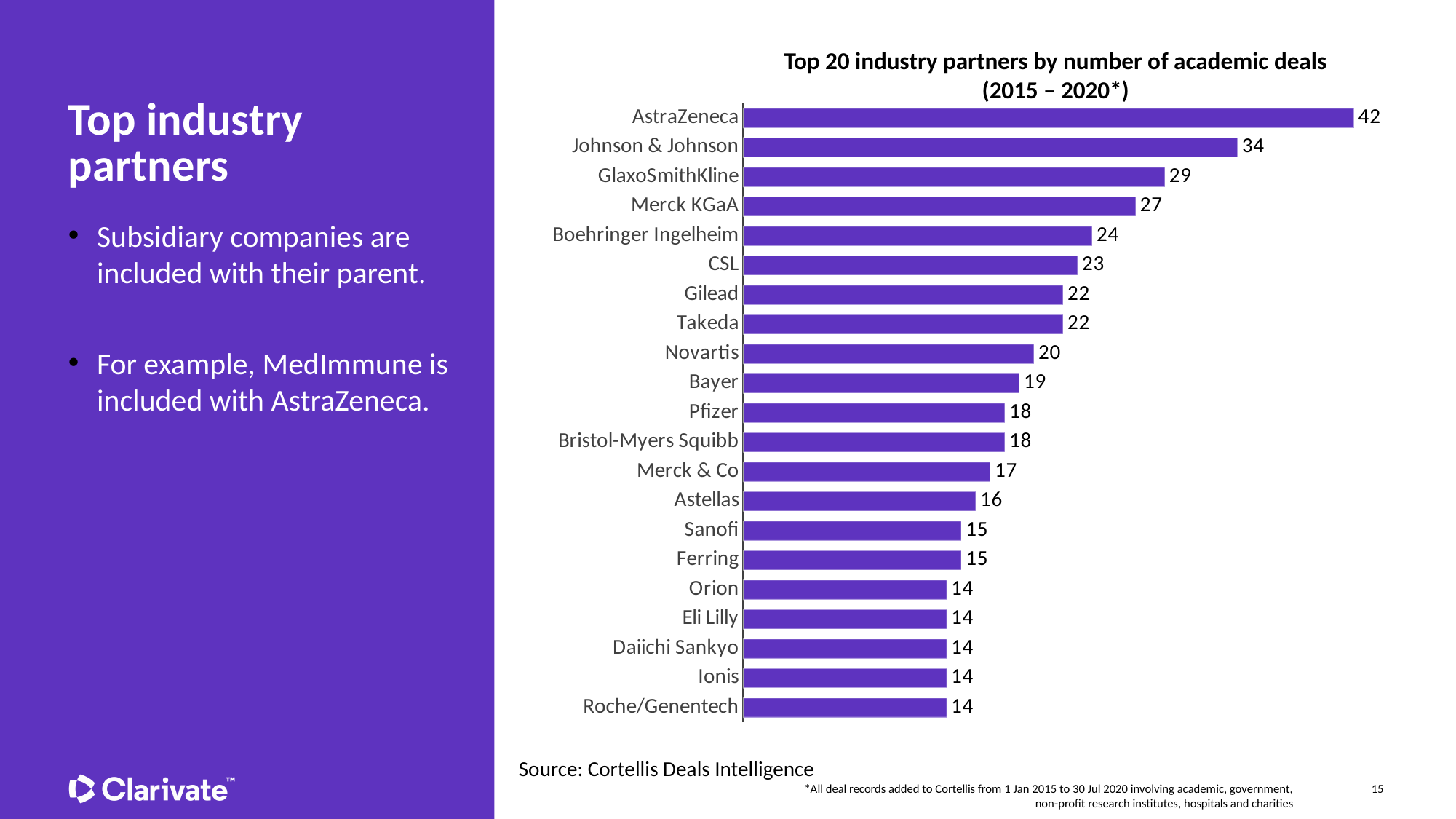
How many academic deals does AstraZeneca have in the chart? 42 How many industry partners are shown in the chart? 21 Which has more academic deals, CSL or Novartis? CSL What is the value shown for Boehringer Ingelheim? 24 What is the difference in academic deals between AstraZeneca and Johnson & Johnson? 8 What is the title of the chart? Top 20 industry partners by number of academic deals (2015 – 2020*) What is the value shown for Sanofi? 15 Which has more academic deals, Bayer or Astellas? Bayer What type of chart is shown on the slide? Bar chart What is the source cited for the chart? Cortellis Deals Intelligence Which industry partner has the highest number of academic deals? AstraZeneca What is the difference between GlaxoSmithKline and Merck KGaA? 2